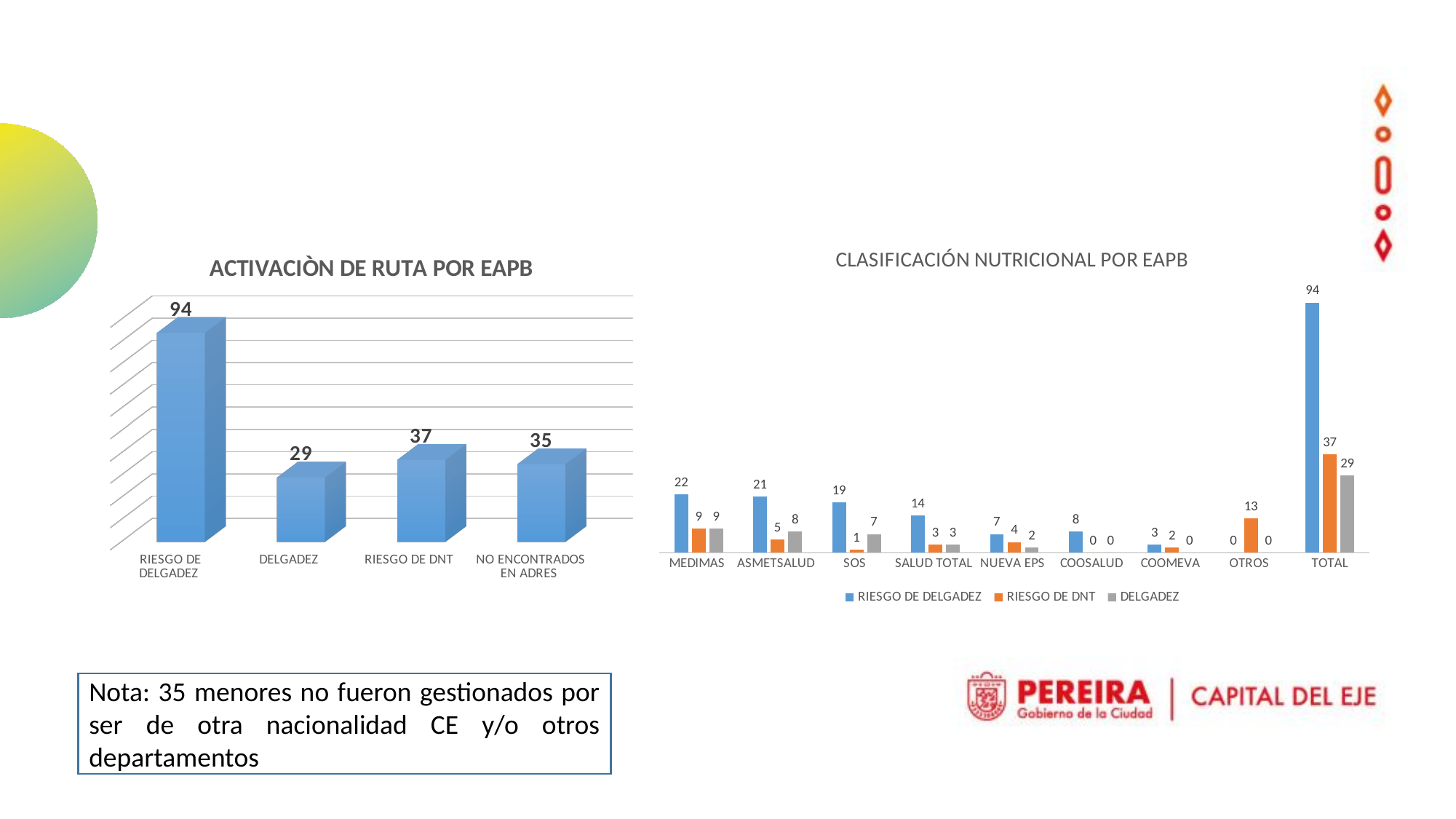
In the chart titled 'ACTIVACIÒN DE RUTA POR EAPB', which category has the highest value? RIESGO DE DELGADEZ In the chart titled 'ACTIVACIÒN DE RUTA POR EAPB', what is the difference between RIESGO DE DELGADEZ and NO ENCONTRADOS EN ADRES? 59 In the chart titled 'CLASIFICACIÓN NUTRICIONAL POR EAPB', what is the DELGADEZ value for ASMETSALUD? 8 In the chart titled 'ACTIVACIÒN DE RUTA POR EAPB', what is the value for RIESGO DE DNT? 37 In the chart titled 'CLASIFICACIÓN NUTRICIONAL POR EAPB', which colour represents the RIESGO DE DNT series? Orange In the chart titled 'ACTIVACIÒN DE RUTA POR EAPB', how many categories are shown? 4 In the chart titled 'CLASIFICACIÓN NUTRICIONAL POR EAPB', what is the RIESGO DE DNT value for OTROS? 13 What kind of chart is the one titled 'ACTIVACIÒN DE RUTA POR EAPB'? Bar chart In the chart titled 'CLASIFICACIÓN NUTRICIONAL POR EAPB', how many series does the legend list? 3 In the chart titled 'ACTIVACIÒN DE RUTA POR EAPB', which category has the lowest value? DELGADEZ In the chart titled 'CLASIFICACIÓN NUTRICIONAL POR EAPB', which is larger for SOS: RIESGO DE DELGADEZ or DELGADEZ? RIESGO DE DELGADEZ In the chart titled 'CLASIFICACIÓN NUTRICIONAL POR EAPB', what is the difference between the RIESGO DE DELGADEZ values for MEDIMAS and SALUD TOTAL? 8